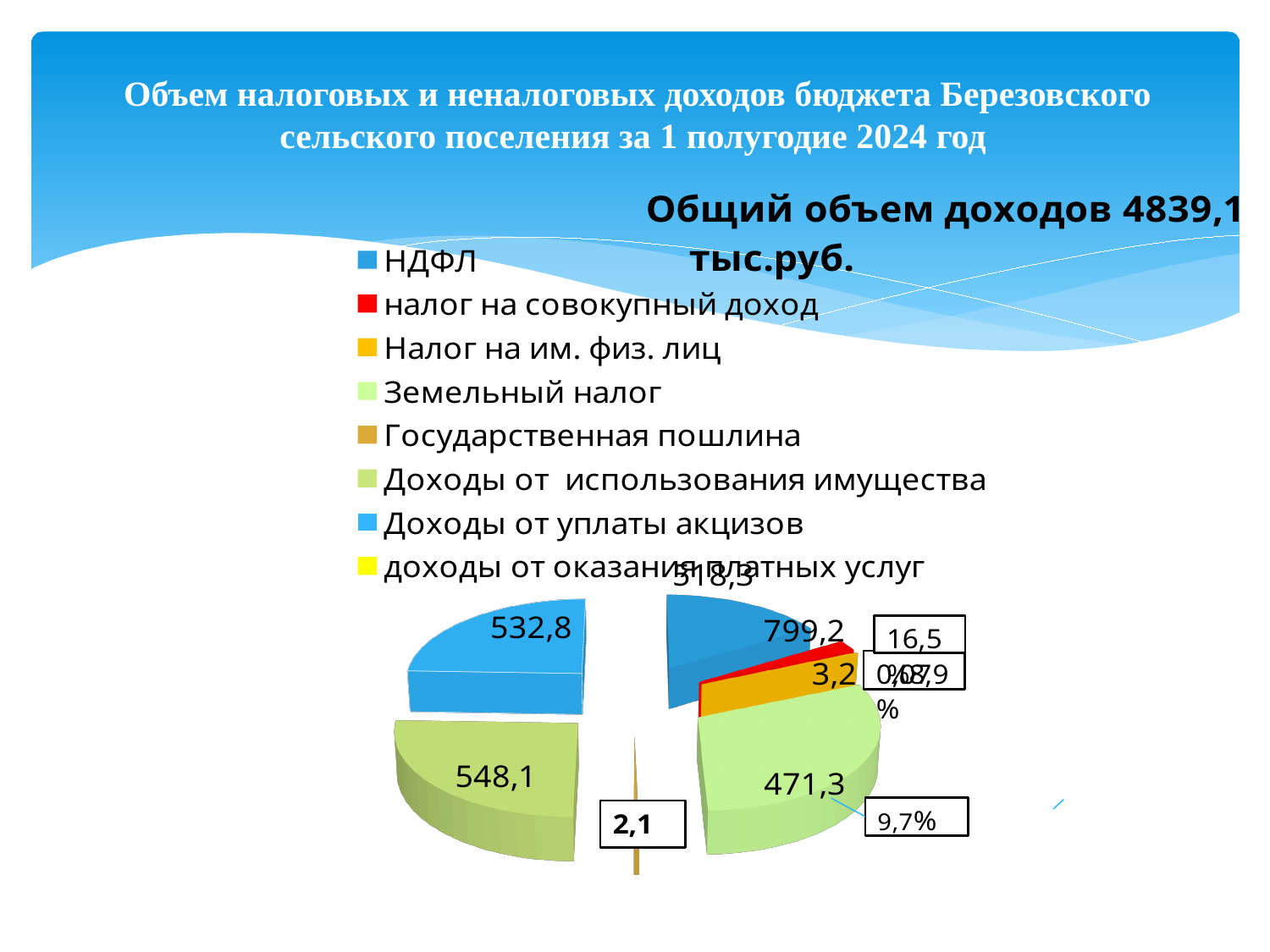
What is the difference between the НДФЛ value and the Доходы от уплаты акцизов value? 266,4 What is the difference between the Доходы от использования имущества value and the Земельный налог value? 76,8 How many entries does the legend of the pie chart list? 8 What value is shown for the Государственная пошлина slice? 2,1 Which category has the largest labelled value in the pie chart? НДФЛ What value is shown for the Доходы от использования имущества slice? 548,1 Which is larger, the value for Доходы от использования имущества or the value for Доходы от уплаты акцизов? Доходы от использования имущества What total income volume is stated in the text next to the chart? 4839,1 тыс.руб. What value is shown for the Доходы от уплаты акцизов slice? 532,8 What kind of chart is shown on the slide? pie chart What value is shown for the Земельный налог slice? 471,3 What value is shown for the НДФЛ slice? 799,2